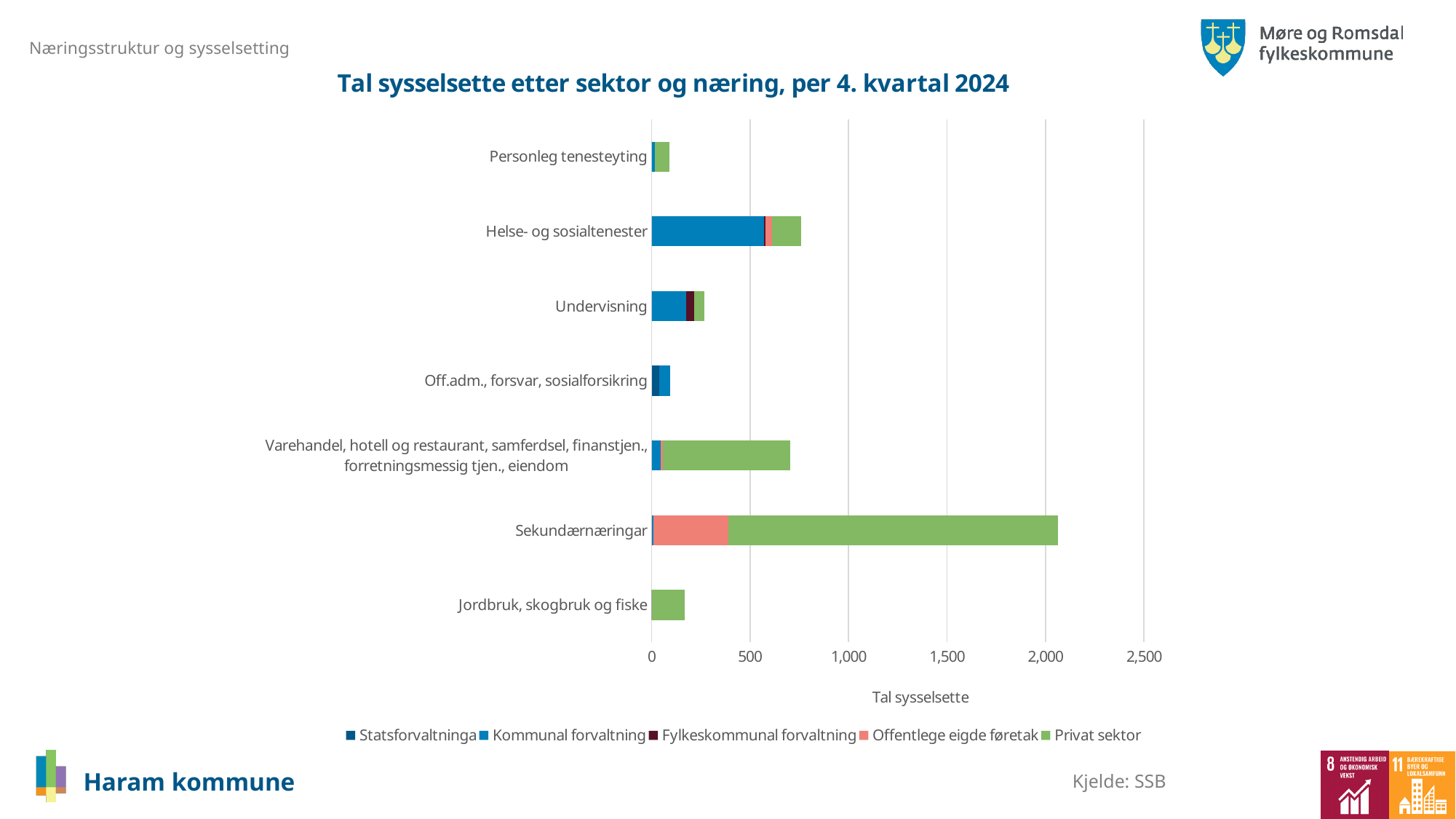
Is the total value for Helse- og sosialtenester greater or less than 500? greater What kind of chart is shown on the slide? Stacked bar chart What is the title of the chart? Tal sysselsette etter sektor og næring, per 4. kvartal 2024 How many series does the legend list? 5 Which has a larger total, Sekundærnæringar or Helse- og sosialtenester? Sekundærnæringar What is the label on the horizontal axis? Tal sysselsette Is the total value for Jordbruk, skogbruk og fiske greater or less than 500? less Which has a larger total, Undervisning or Jordbruk, skogbruk og fiske? Undervisning Is the total value for Sekundærnæringar greater or less than 2,000? greater Which category has the highest total number of sysselsette? Sekundærnæringar How many categories (næringar) are plotted on the chart? 7